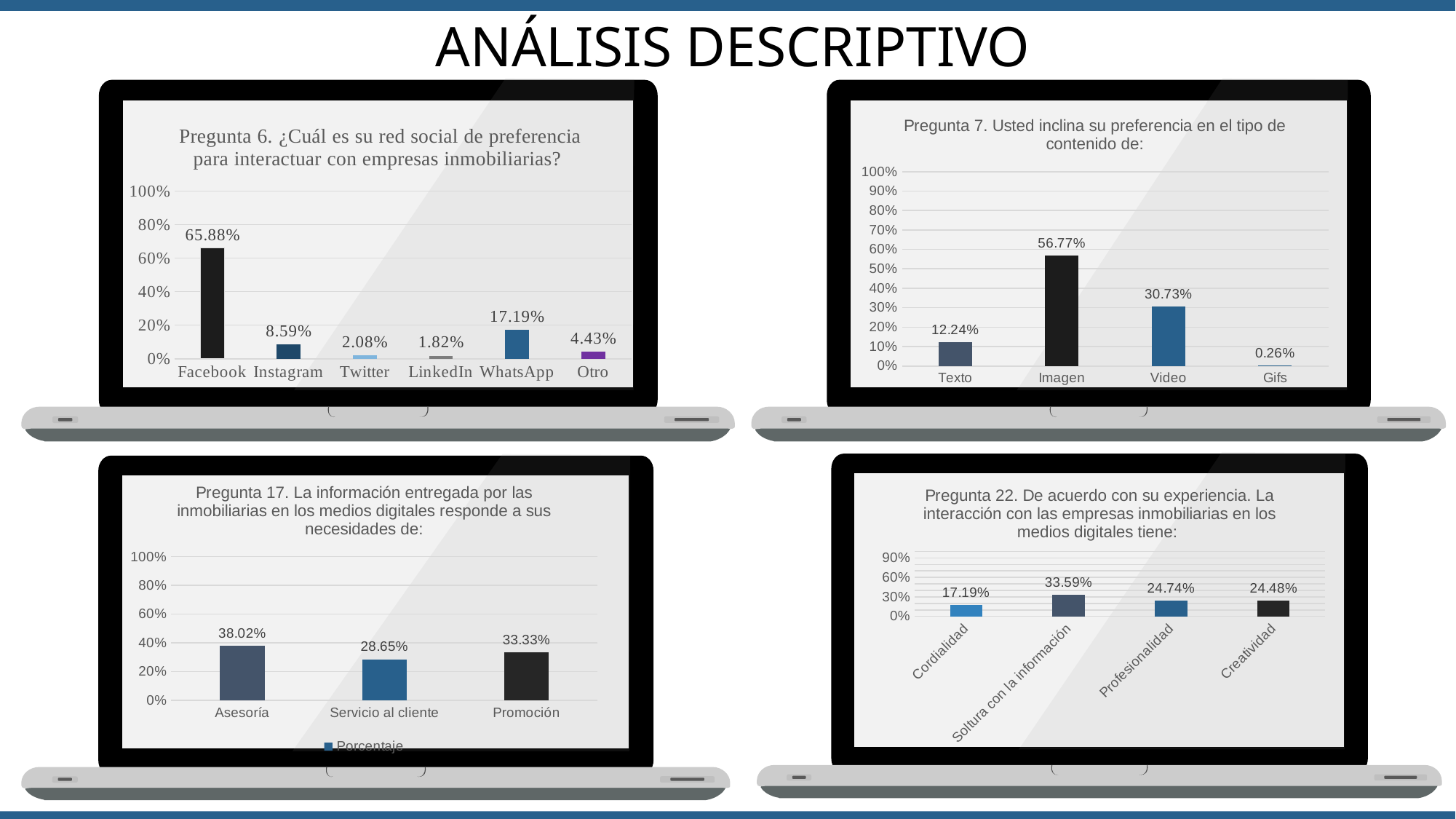
In the Pregunta 17 chart (bottom left), what series name does the legend show? Porcentaje In the Pregunta 22 chart (bottom right), what is the value for Soltura con la información? 33.59% In the Pregunta 7 chart (top right), what is the value for Video? 30.73% What type of chart is the Pregunta 22 chart (bottom right)? Bar chart In the Pregunta 7 chart (top right), what is the difference between the Imagen and Video values? 26.04% In the Pregunta 6 chart (top left), what is the value for Facebook? 65.88% In the Pregunta 6 chart (top left), which social network has the lowest value? LinkedIn In the Pregunta 6 chart (top left), what is the difference between the Facebook and WhatsApp values? 48.69% In the Pregunta 7 chart (top right), which content type has the highest value? Imagen In the Pregunta 17 chart (bottom left), which of Asesoría or Promoción has the larger value? Asesoría In the Pregunta 6 chart (top left), how many categories are shown on the x axis? 6 In the Pregunta 17 chart (bottom left), what is the value for Servicio al cliente? 28.65%